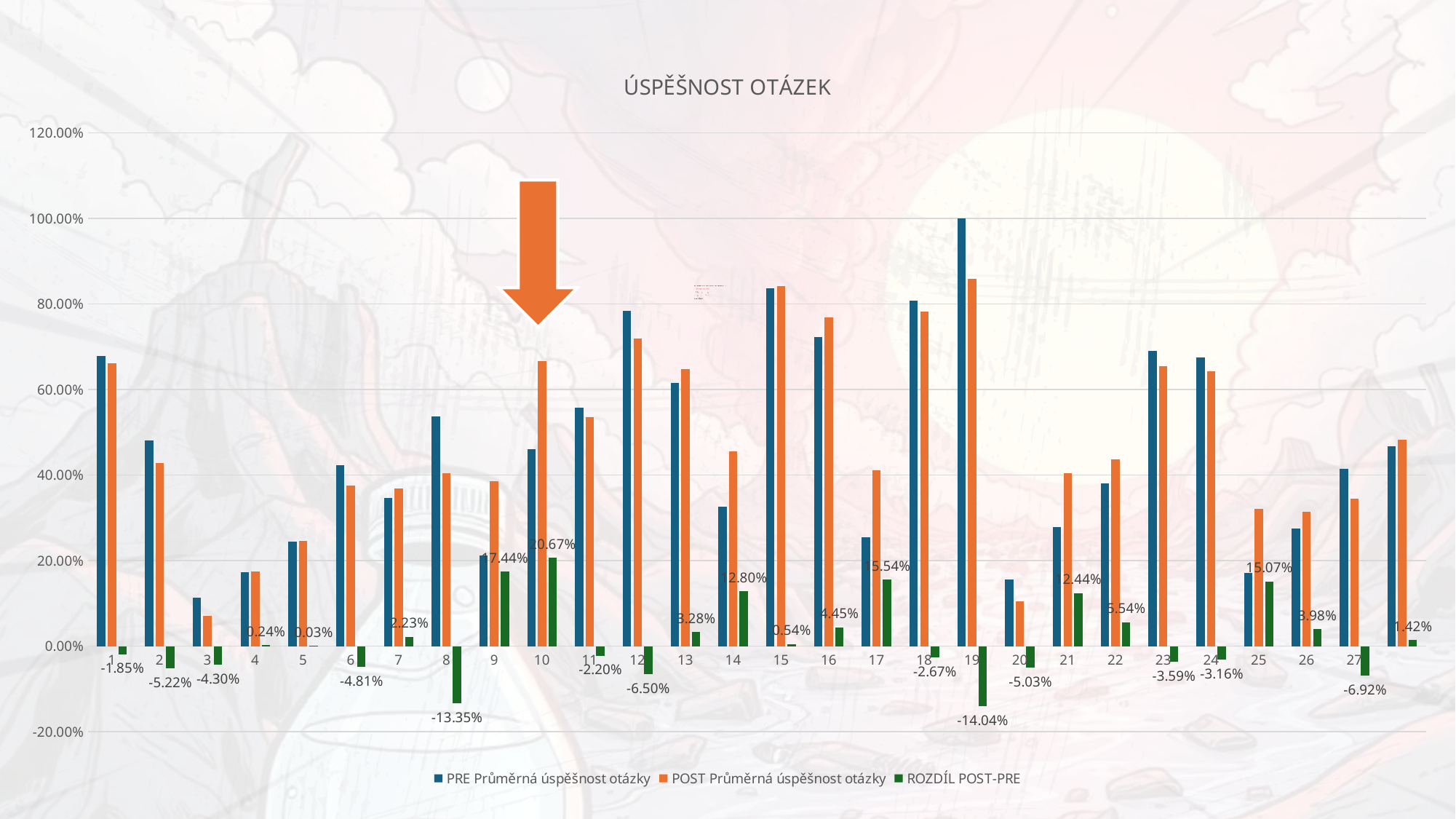
Is the PRE Průměrná úspěšnost otázky value for question 19 greater or less than 80.00%? greater Which question has the highest ROZDÍL POST-PRE value? 10 For question 10, which is larger: the PRE or the POST average success? POST Průměrná úspěšnost otázky What is the ROZDÍL POST-PRE value for question 8? -13.35% Which question has the lowest ROZDÍL POST-PRE value? 19 How many series does the legend list? 3 What is the title of the chart? ÚSPĚŠNOST OTÁZEK What kind of chart is shown on the slide? bar chart What is the ROZDÍL POST-PRE value for question 19? -14.04% What is the ROZDÍL POST-PRE value for question 10? 20.67% What is the difference between the ROZDÍL POST-PRE values for question 10 and question 9? 3.23% Is the POST Průměrná úspěšnost otázky value for question 3 greater or less than 20.00%? less